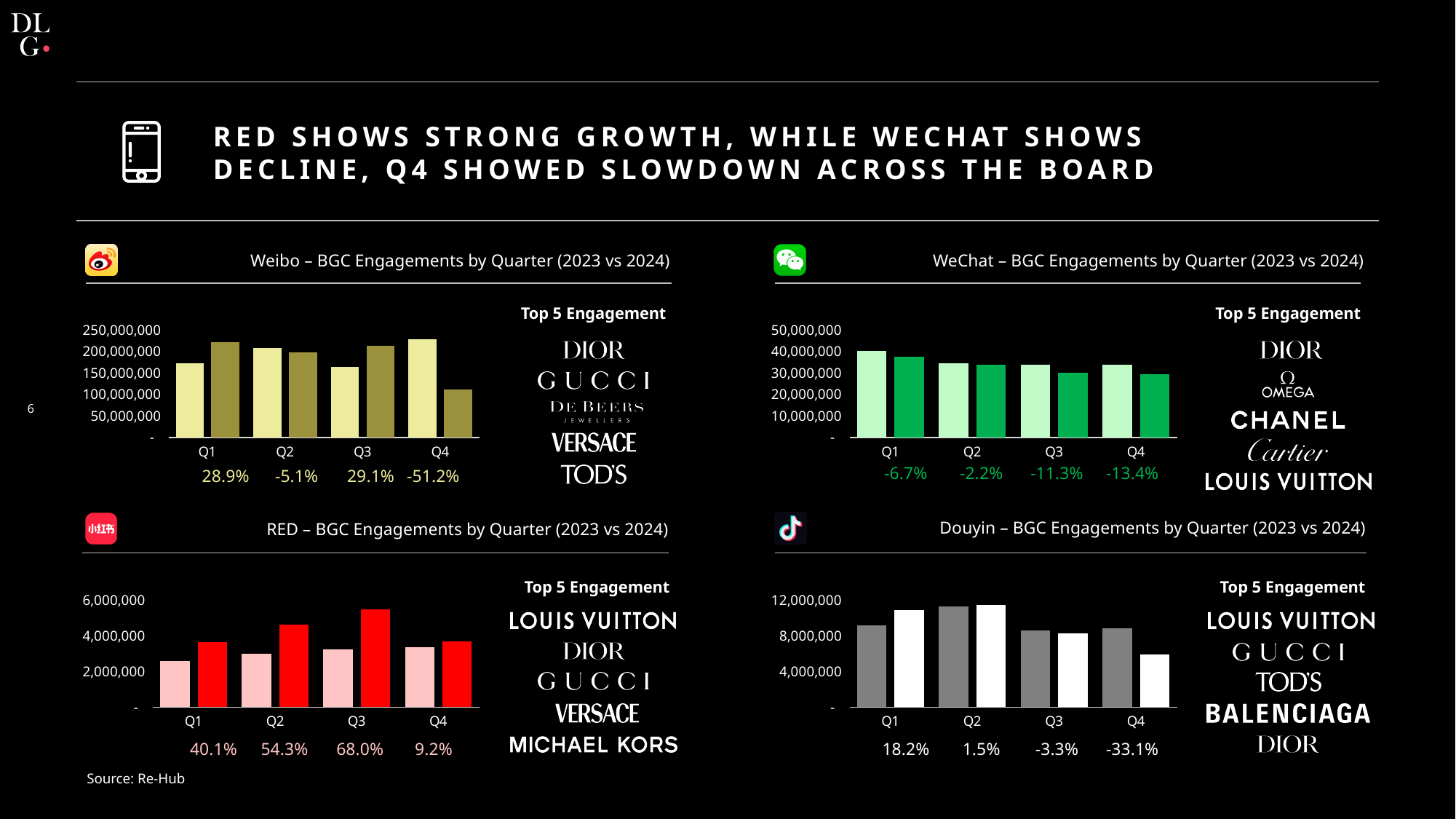
In the WeChat chart, do the bars generally rise or fall from Q1 to Q4? fall In the Douyin chart, what is the year-over-year change shown under Q1? 18.2% In the RED chart, is the value of the bright red (2024) bar for Q3 greater or less than 4,000,000? greater In the RED chart, what is the year-over-year change shown under Q3? 68.0% In the RED chart, which quarter has the tallest bar? Q3 In the Weibo chart, is the value of the darker (2024) bar for Q4 greater or less than 150,000,000? less In the Douyin chart, is the value of the white (2024) bar for Q4 greater or less than 8,000,000? less In the WeChat chart, what is the year-over-year change shown under Q3? -11.3% In the Weibo chart, which quarter has the shortest bar? Q4 How many quarters are shown on the x axis of the RED chart? 4 In the Weibo chart, what is the year-over-year change shown under Q4? -51.2% What kind of chart is the Weibo – BGC Engagements by Quarter chart? bar chart